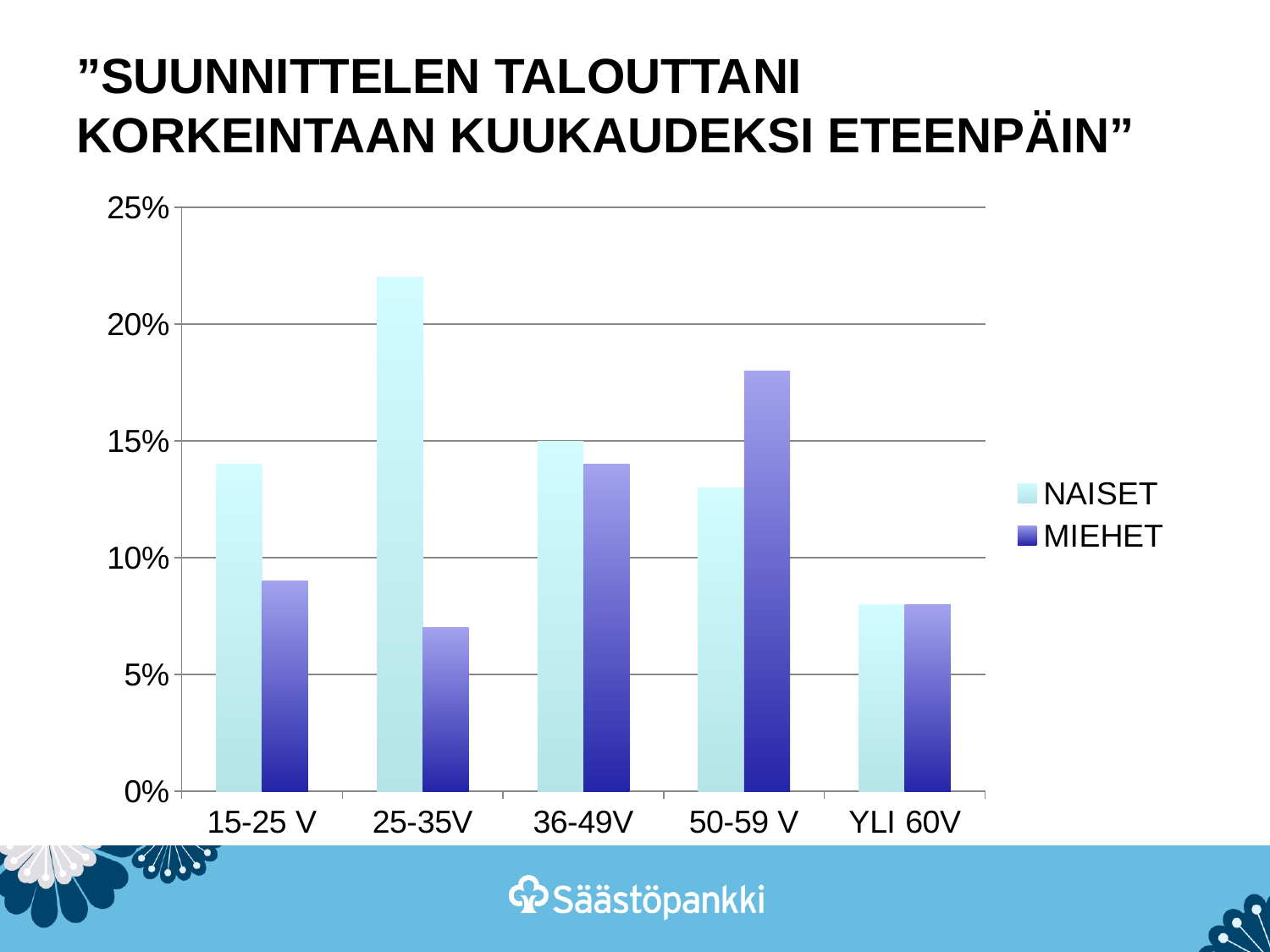
How many age groups are shown on the x axis? 5 Which age group has the highest value for NAISET? 25-35V Is the MIEHET value for 50-59 V greater or less than 15%? greater Which age group has the highest value for MIEHET? 50-59 V Which series is shown in light blue in the legend? NAISET For the 15-25 V group, which series has the larger value, NAISET or MIEHET? NAISET Is the MIEHET value for 25-35V greater or less than 10%? less Which age group has the lowest value for NAISET? YLI 60V Which age group has the lowest value for MIEHET? 25-35V What kind of chart is shown on the slide? bar chart Is the NAISET value for 25-35V greater or less than 20%? greater How many series does the legend list? 2